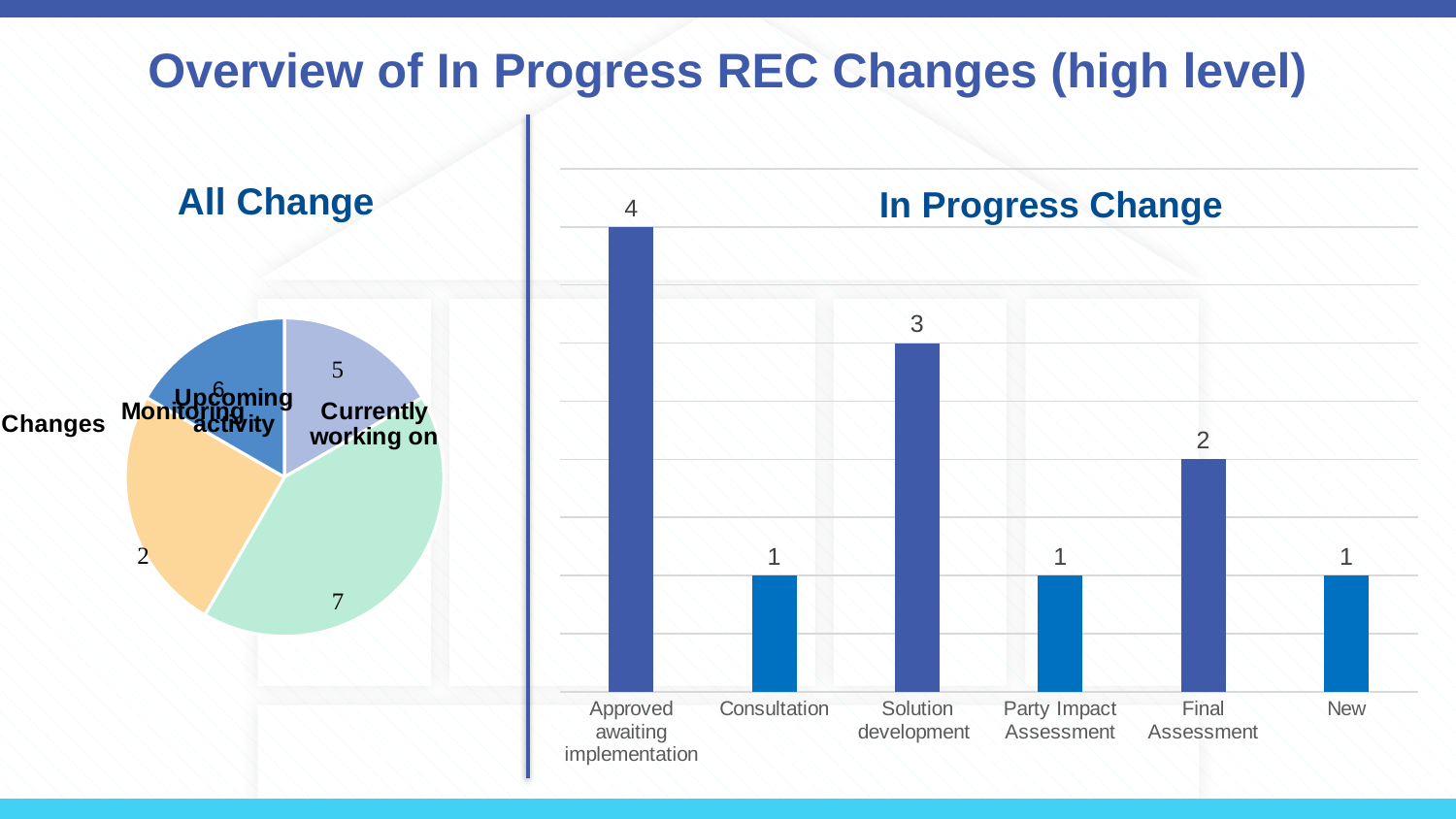
What kind of chart is the 'In Progress Change' chart? Bar chart In the 'In Progress Change' chart, which category has the highest value? Approved awaiting implementation In the 'In Progress Change' chart, what is the value for Solution development? 3 In the 'In Progress Change' chart, what is the difference between Approved awaiting implementation and Solution development? 1 In the 'In Progress Change' chart, which is larger: Solution development or Final Assessment? Solution development What kind of chart is the 'All Change' chart? Pie chart How many categories are shown in the 'In Progress Change' chart? 6 In the 'All Change' pie chart, what is the value of the largest slice? 7 In the 'In Progress Change' chart, what is the value for Approved awaiting implementation? 4 In the 'In Progress Change' chart, what is the value for Final Assessment? 2 In the 'All Change' pie chart, what is the value of the 'Currently working on' slice? 5